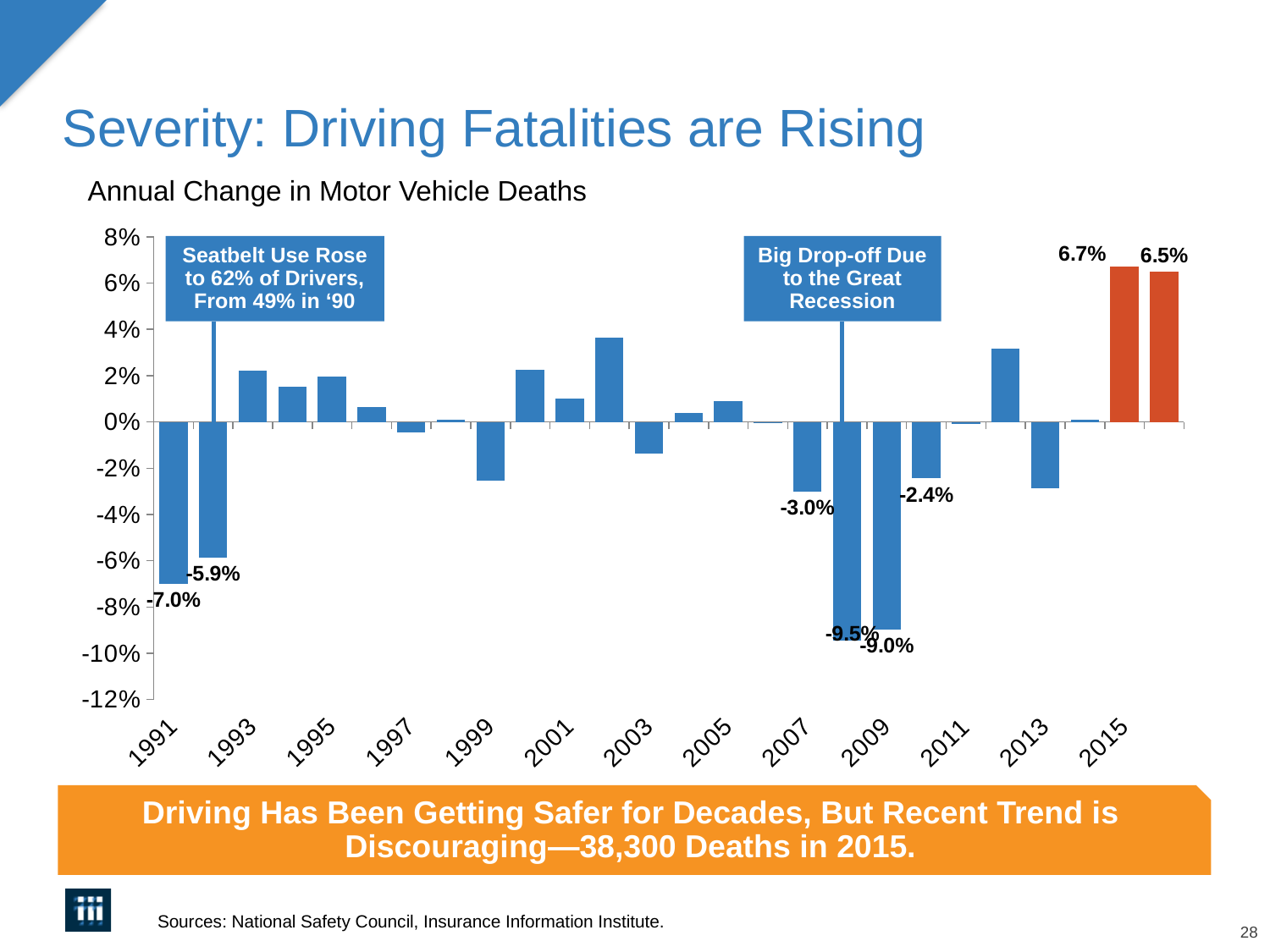
What is the value labeled on the bar for 2015? 6.7% Is the value for 2013 greater or less than -2%? less What is the value labeled on the bar for 2007? -3.0% What colour are the bars for the two most recent years on the chart? Orange What is the highest value labeled on the chart? 6.7% Is the value for 1999 greater or less than 0%? less What is the difference between the values for 1991 (-7.0%) and 2007 (-3.0%)? 4.0 percentage points What is the difference between the 6.7% bar and the 6.5% bar? 0.2 percentage points What kind of chart is shown on the slide? Bar chart Which year has the larger decline, 1991 or 2007? 1991 What is the lowest value labeled on the chart? -9.5% What is the annual change in motor vehicle deaths shown for 1991? -7.0%